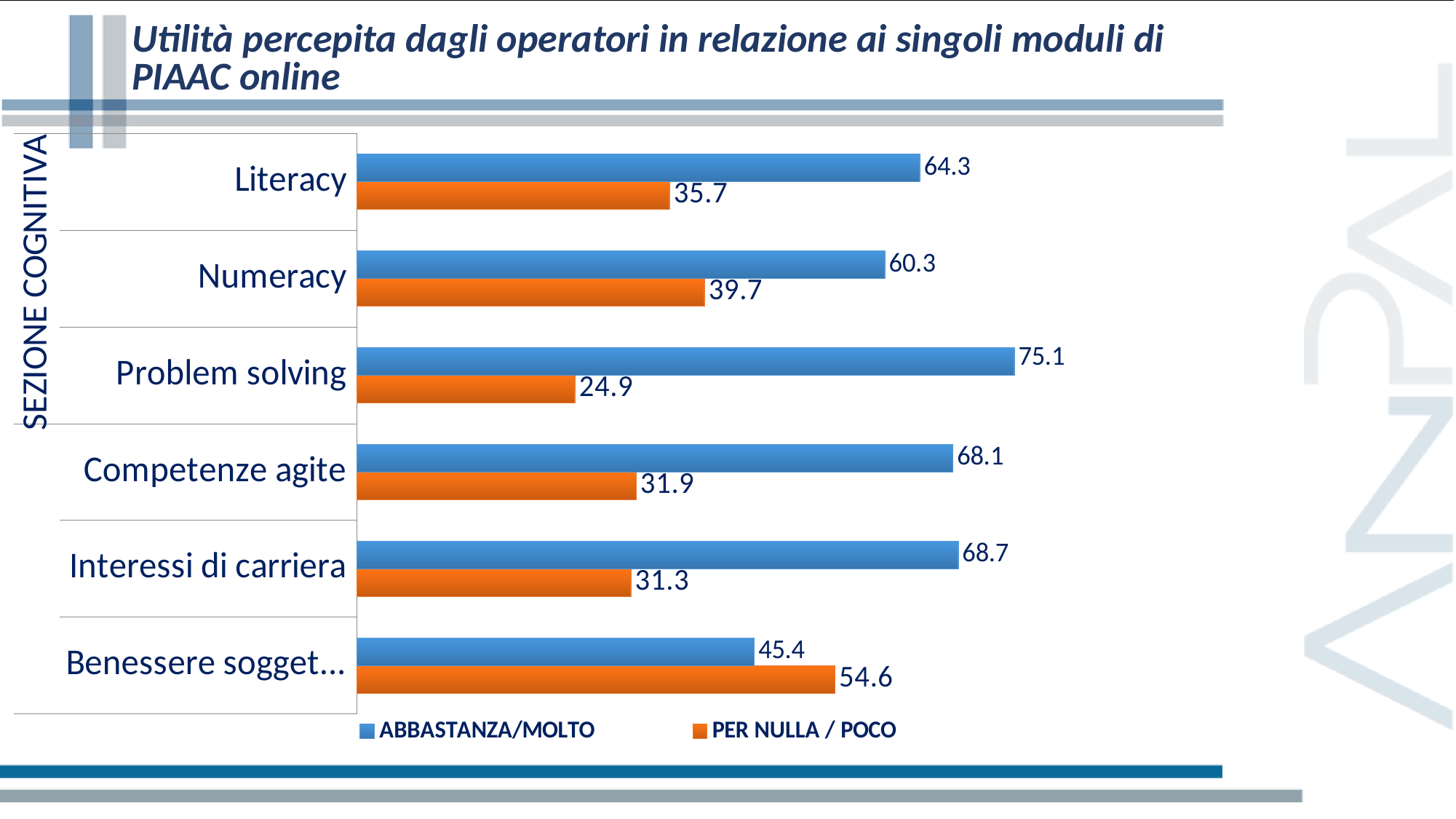
What is the ABBASTANZA/MOLTO value for Literacy? 64.3 Which category has the highest ABBASTANZA/MOLTO value? Problem solving How many categories are shown on the chart? 6 What kind of chart is shown on the slide? Bar chart Which colour represents the PER NULLA / POCO series? Orange What is the difference between the ABBASTANZA/MOLTO and PER NULLA / POCO values for Competenze agite? 36.2 What is the ABBASTANZA/MOLTO value for Problem solving? 75.1 What is the difference between the ABBASTANZA/MOLTO values for Problem solving and Numeracy? 14.8 What is the PER NULLA / POCO value for Numeracy? 39.7 Which is larger for Interessi di carriera: ABBASTANZA/MOLTO or PER NULLA / POCO? ABBASTANZA/MOLTO Which category has the lowest PER NULLA / POCO value? Problem solving How many series does the legend list? 2